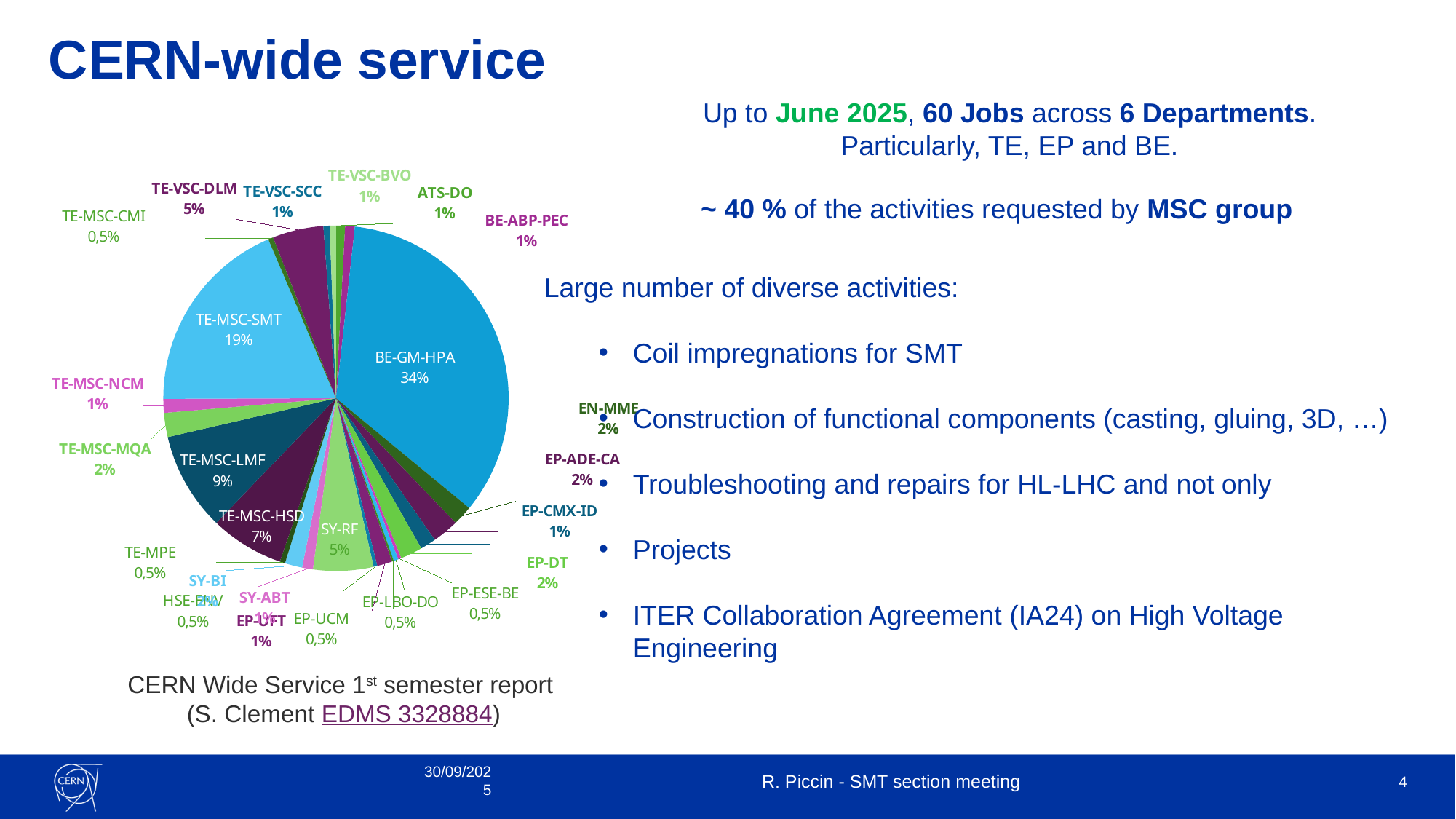
What is the value shown for SY-RF? 5% What is the value shown for TE-MSC-LMF? 9% What is the value shown for TE-MSC-SMT? 19% What is the difference between the shares of BE-GM-HPA and TE-MSC-SMT? 15% What is the value shown for EP-DT? 2% What is the value shown for TE-MSC-CMI? 0,5% Which is larger, the share of TE-MSC-LMF or TE-MSC-HSD? TE-MSC-LMF What is the value shown for TE-VSC-DLM? 5% Which category has the largest slice of the pie? BE-GM-HPA What is the value shown for TE-MSC-HSD? 7% What kind of chart is shown on the slide? pie chart What share of the pie does BE-GM-HPA hold? 34%